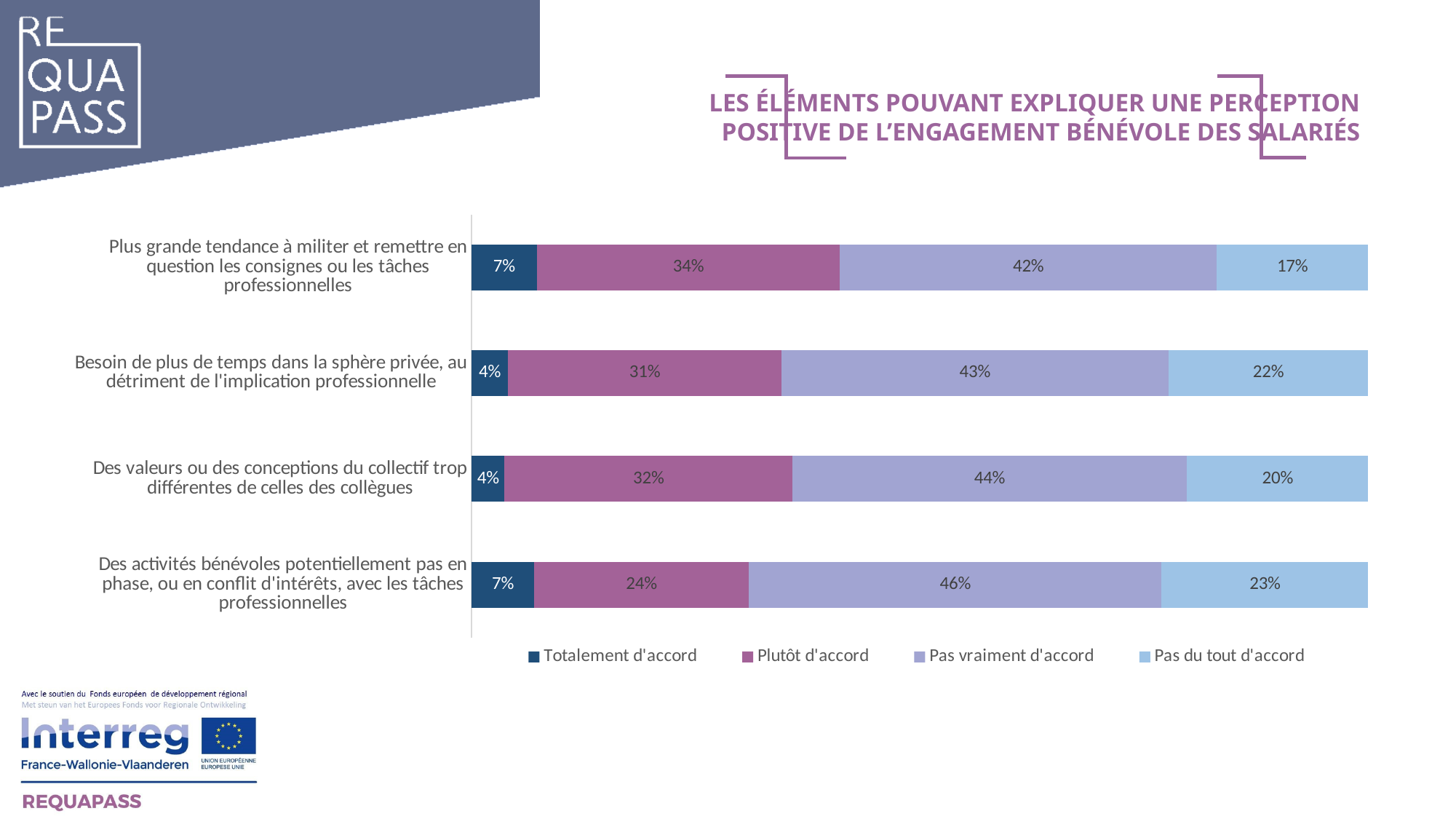
What is the 'Plutôt d'accord' value for 'Plus grande tendance à militer et remettre en question les consignes ou les tâches professionnelles'? 34% Which is larger: the 'Pas du tout d'accord' value for 'Des valeurs ou des conceptions du collectif trop différentes de celles des collègues' or for 'Plus grande tendance à militer et remettre en question les consignes ou les tâches professionnelles'? Des valeurs ou des conceptions du collectif trop différentes de celles des collègues What is the 'Totalement d'accord' value for 'Des valeurs ou des conceptions du collectif trop différentes de celles des collègues'? 4% What is the 'Pas vraiment d'accord' value for 'Des activités bénévoles potentiellement pas en phase, ou en conflit d'intérêts, avec les tâches professionnelles'? 46% What is the difference between the 'Plutôt d'accord' values for 'Plus grande tendance à militer et remettre en question les consignes ou les tâches professionnelles' and 'Des activités bénévoles potentiellement pas en phase, ou en conflit d'intérêts, avec les tâches professionnelles'? 10% What is the combined 'Totalement d'accord' and 'Plutôt d'accord' share for 'Besoin de plus de temps dans la sphère privée, au détriment de l'implication professionnelle'? 35% Which category has the lowest 'Plutôt d'accord' value? Des activités bénévoles potentiellement pas en phase, ou en conflit d'intérêts, avec les tâches professionnelles How many categories are shown in the chart? 4 Which category has the highest 'Pas vraiment d'accord' value? Des activités bénévoles potentiellement pas en phase, ou en conflit d'intérêts, avec les tâches professionnelles What is the 'Pas du tout d'accord' value for 'Besoin de plus de temps dans la sphère privée, au détriment de l'implication professionnelle'? 22% How many series does the legend list? 4 What kind of chart is shown on the slide? Stacked bar chart